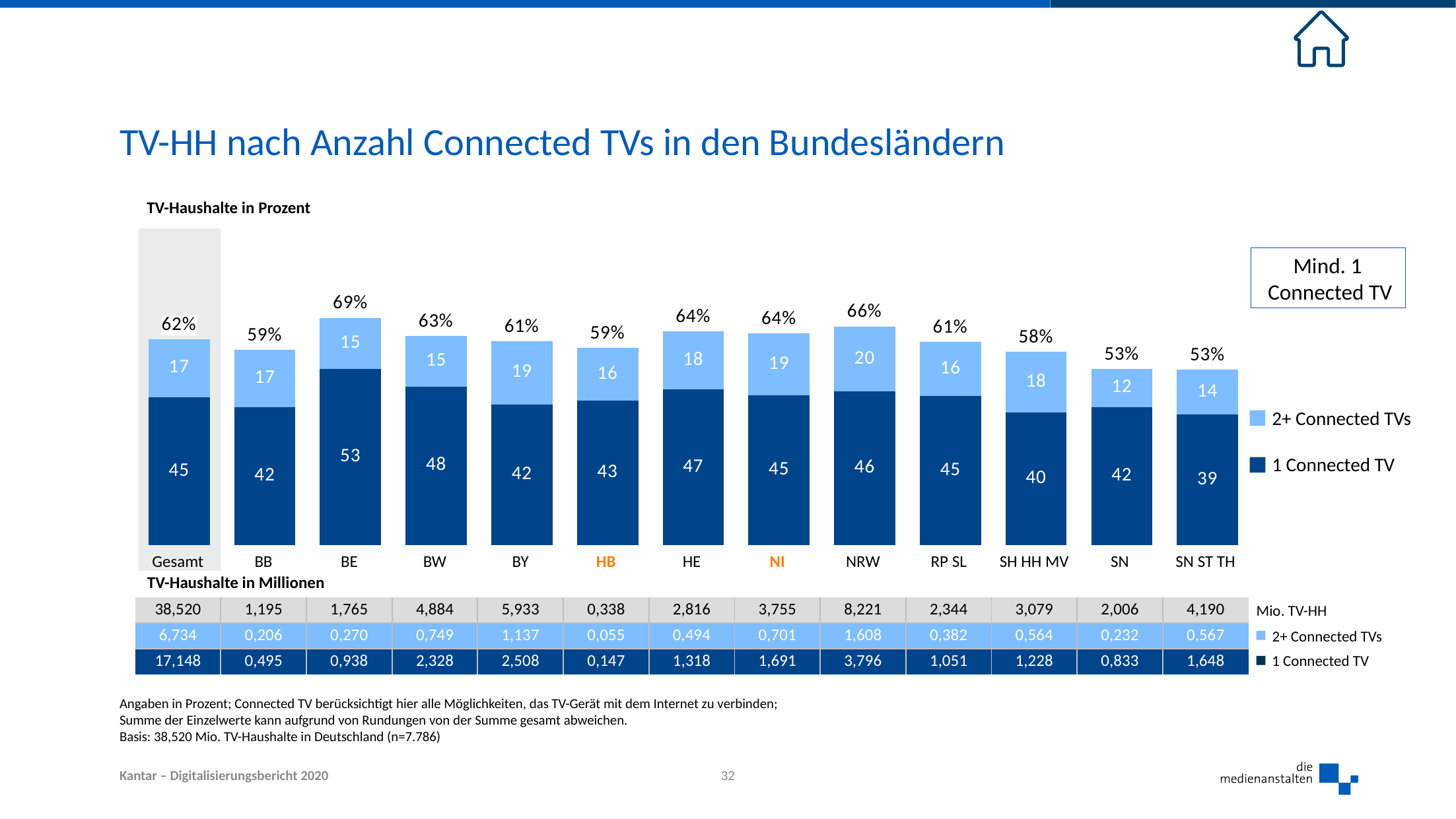
Which has a larger value for 1 Connected TV, BW or BY? BW What percentage is shown above the bar for Gesamt? 62% How many series does the legend list? 2 What is the value for 2+ Connected TVs in NRW? 20 Which category has the highest percentage shown above its bar? BE What kind of chart is shown on the slide? Stacked bar chart What is the title of the slide? TV-HH nach Anzahl Connected TVs in den Bundesländern What is the difference between the 1 Connected TV values for BE and SN ST TH? 14 How many categories are shown on the x axis of the chart? 13 Which category has the lowest value for 1 Connected TV? SN ST TH Which category has the highest value for 2+ Connected TVs? NRW What is the value for 1 Connected TV in BE? 53